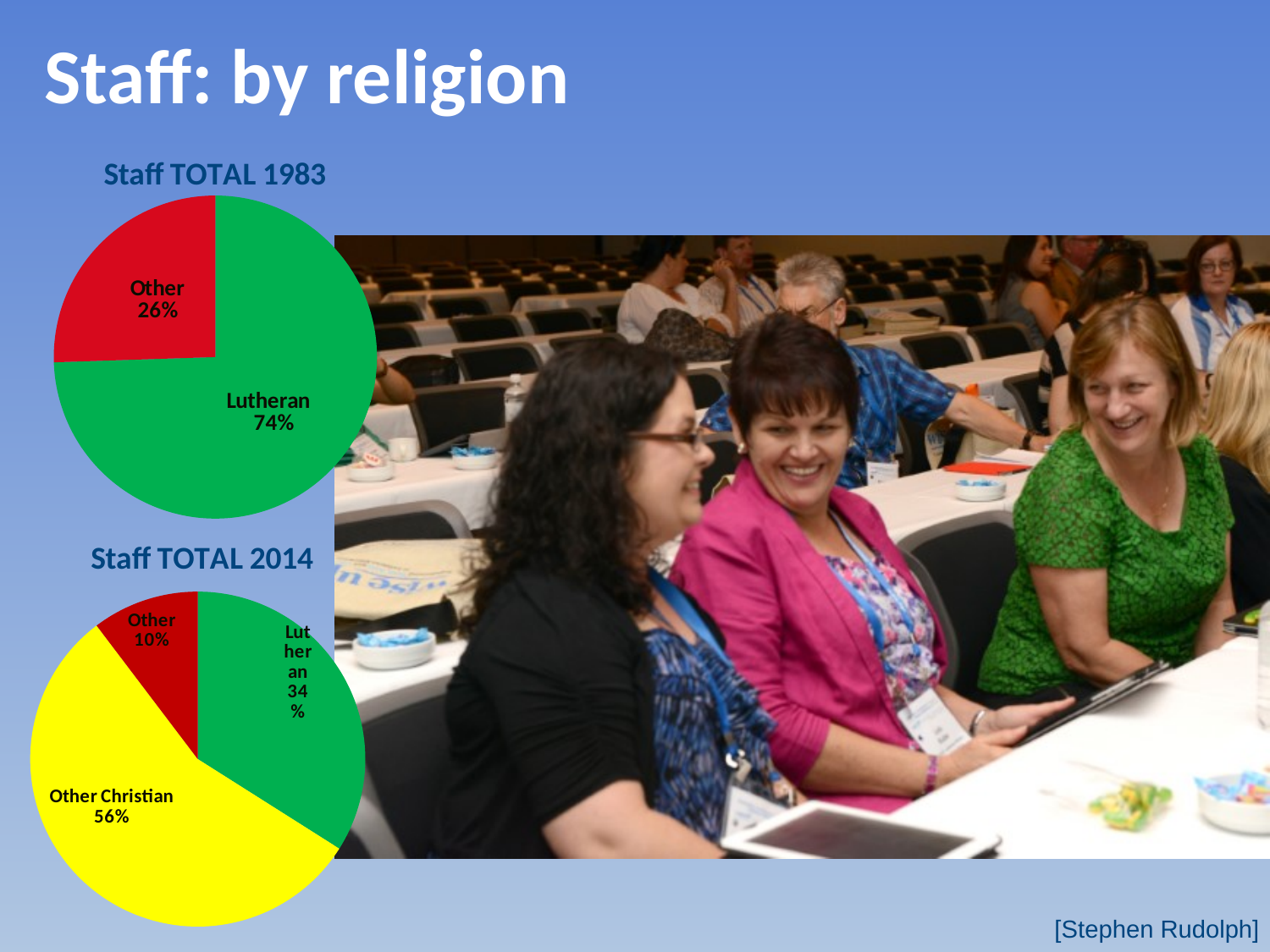
In the 'Staff TOTAL 1983' chart, which category has the largest slice? Lutheran In the 'Staff TOTAL 2014' chart, what share of staff is Other? 10% In the 'Staff TOTAL 1983' chart, what share of staff is Lutheran? 74% How many categories does the 'Staff TOTAL 2014' chart show? 3 What kind of chart is 'Staff TOTAL 1983'? Pie chart What is the difference between the Lutheran share in the 'Staff TOTAL 1983' chart and the Lutheran share in the 'Staff TOTAL 2014' chart? 40% In the 'Staff TOTAL 2014' chart, which category has the largest slice? Other Christian In the 'Staff TOTAL 1983' chart, what share of staff is Other? 26% In the 'Staff TOTAL 2014' chart, what share of staff is Other Christian? 56% In the 'Staff TOTAL 2014' chart, which category has the smallest slice? Other In the 'Staff TOTAL 2014' chart, what share of staff is Lutheran? 34% In the 'Staff TOTAL 2014' chart, what colour is the Other Christian slice? Yellow